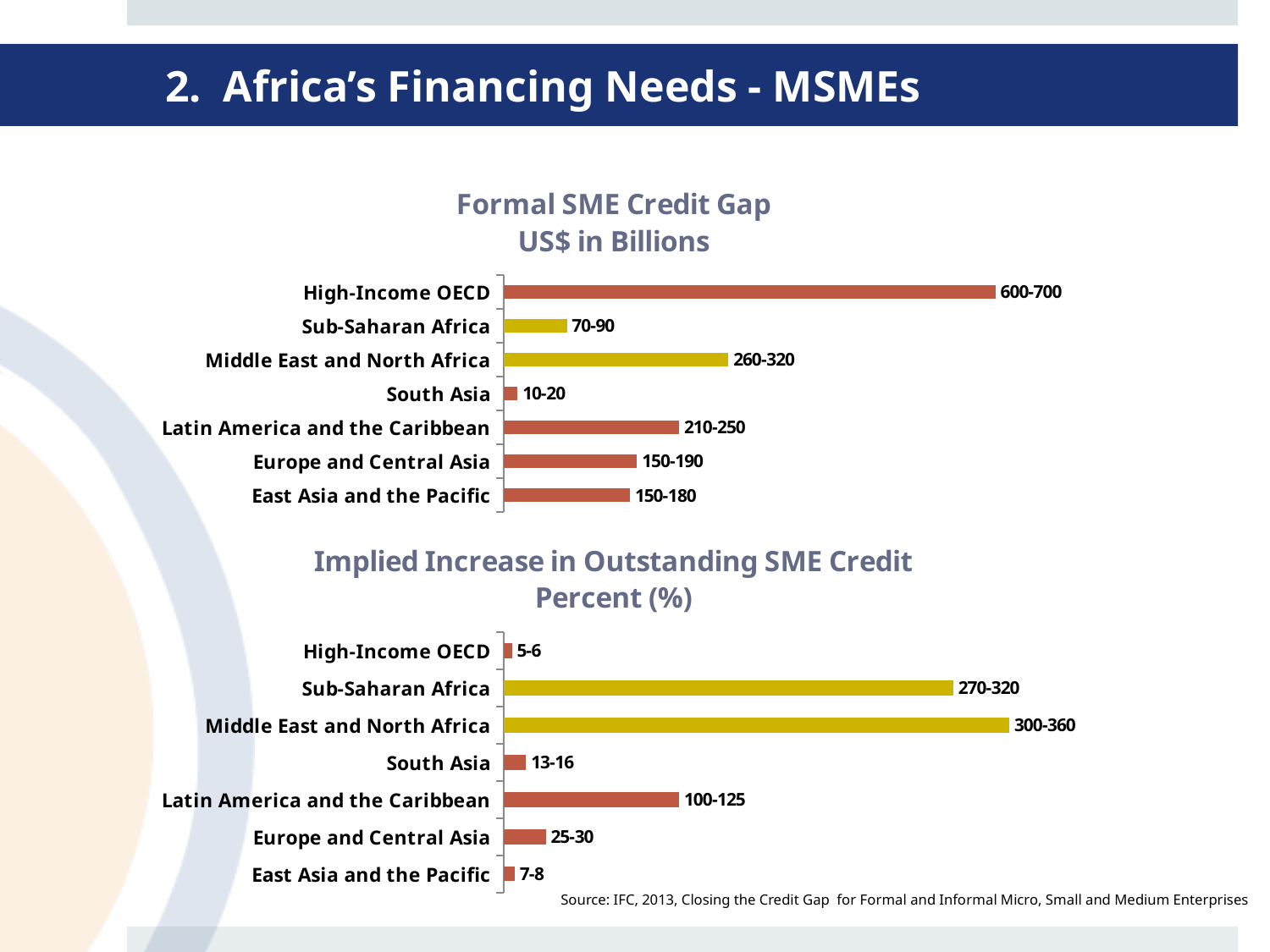
In the 'Formal SME Credit Gap' chart, which is larger: Latin America and the Caribbean or Europe and Central Asia? Latin America and the Caribbean In the 'Implied Increase in Outstanding SME Credit' chart, which region has the highest value? Middle East and North Africa In the 'Formal SME Credit Gap' chart, what is the value for Sub-Saharan Africa? 70-90 In the 'Formal SME Credit Gap' chart, what is the value for Middle East and North Africa? 260-320 In the 'Implied Increase in Outstanding SME Credit' chart, what is the value for Sub-Saharan Africa? 270-320 In the 'Formal SME Credit Gap' chart, which region has the lowest credit gap? South Asia What type of chart is the 'Implied Increase in Outstanding SME Credit' chart? Bar chart In the 'Implied Increase in Outstanding SME Credit' chart, what is the value for Latin America and the Caribbean? 100-125 How many regions are shown in the 'Formal SME Credit Gap' chart? 7 In the 'Implied Increase in Outstanding SME Credit' chart, which region has the lowest value? High-Income OECD In the 'Formal SME Credit Gap' chart, which two regions have yellow bars? Sub-Saharan Africa and Middle East and North Africa In the 'Formal SME Credit Gap' chart, which region has the highest credit gap? High-Income OECD